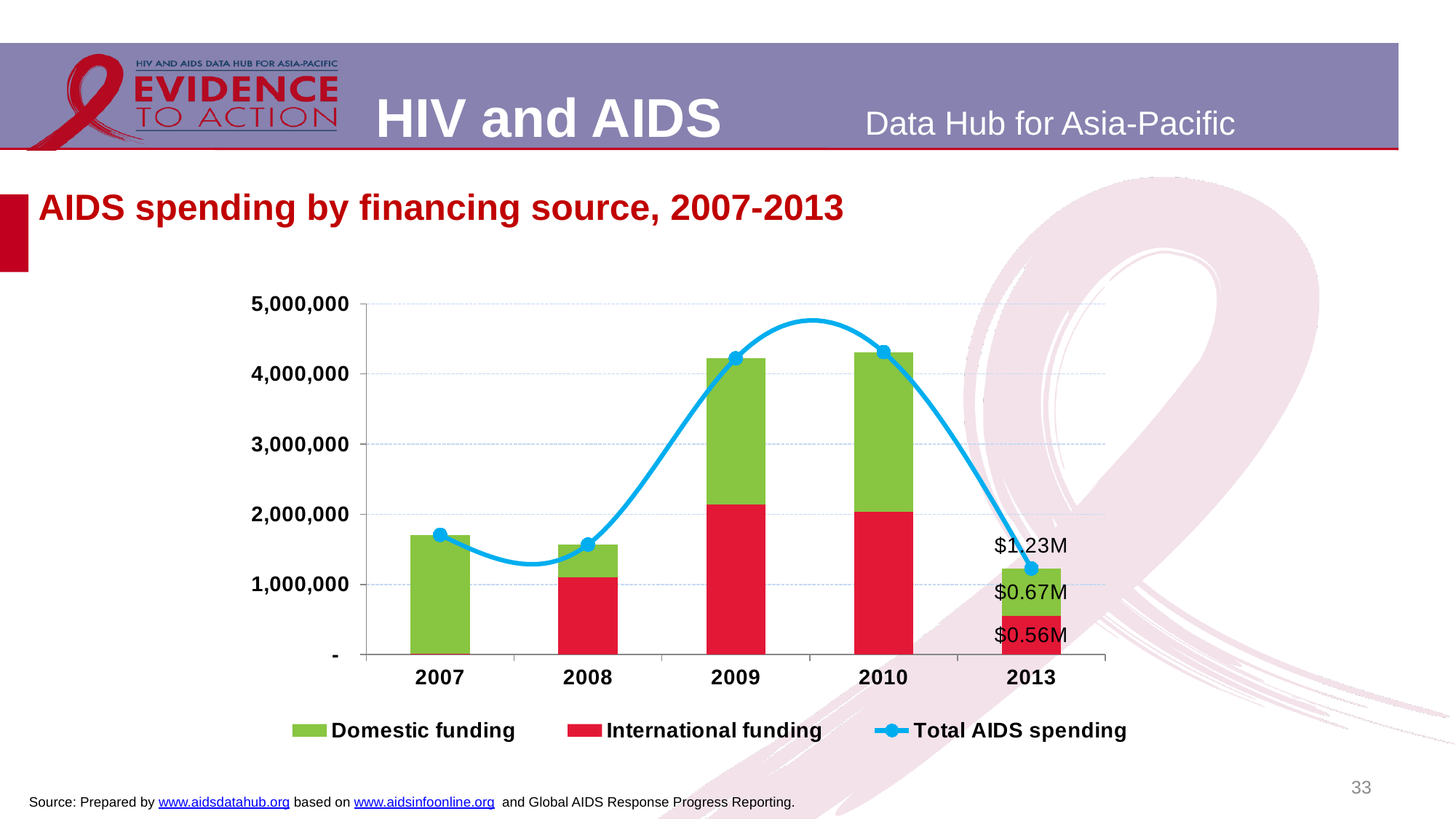
What is the difference between domestic funding and international funding in 2013? $0.12M What is the international funding value labelled for 2013? $0.56M How many series does the legend list? 3 How many years are shown on the x axis? 5 Does total AIDS spending rise or fall from 2010 to 2013? fall What is the domestic funding value labelled for 2013? $0.67M Is the total AIDS spending for 2007 greater or less than 2,000,000? less Which year has the lowest total AIDS spending? 2013 Is the total AIDS spending for 2009 greater or less than 4,000,000? greater Is the international funding for 2008 greater or less than 1,000,000? greater In 2013, which is larger: domestic funding or international funding? Domestic funding What is the total AIDS spending shown for 2013? $1.23M